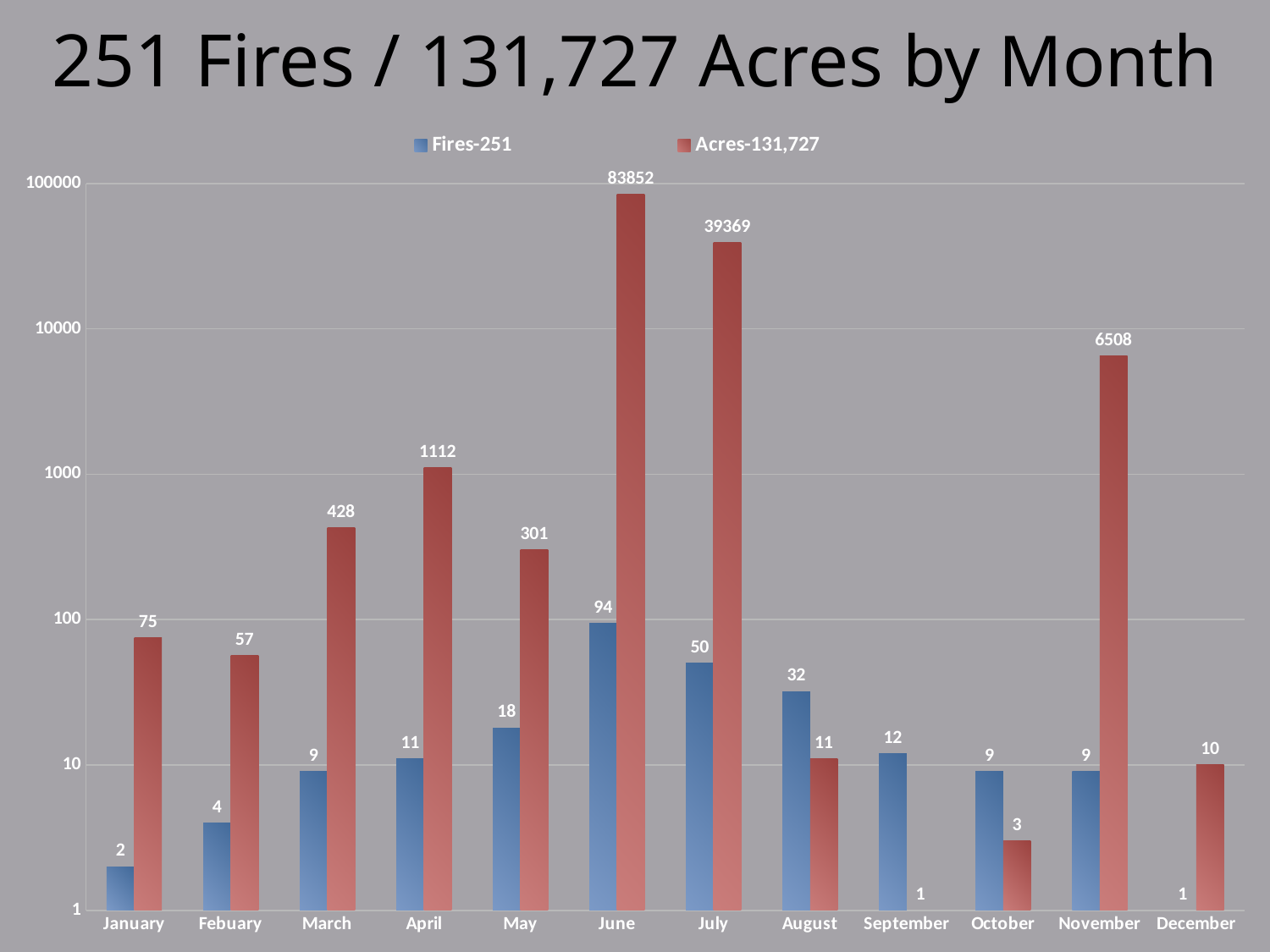
Which month has the highest Fires value? June What is the Fires value for August? 32 What is the title of the chart? 251 Fires / 131,727 Acres by Month What kind of chart is shown on the slide? bar chart Which is larger, the Fires value for July or the Fires value for August? July What is the difference between the Acres values for June and July? 44483 What is the Acres value for June? 83852 How many series does the legend list? 2 Is the Acres value for November greater or less than 1000? greater How many months are shown on the x axis? 12 Which month has the lowest Acres value? September What is the difference between the Fires values for June and May? 76